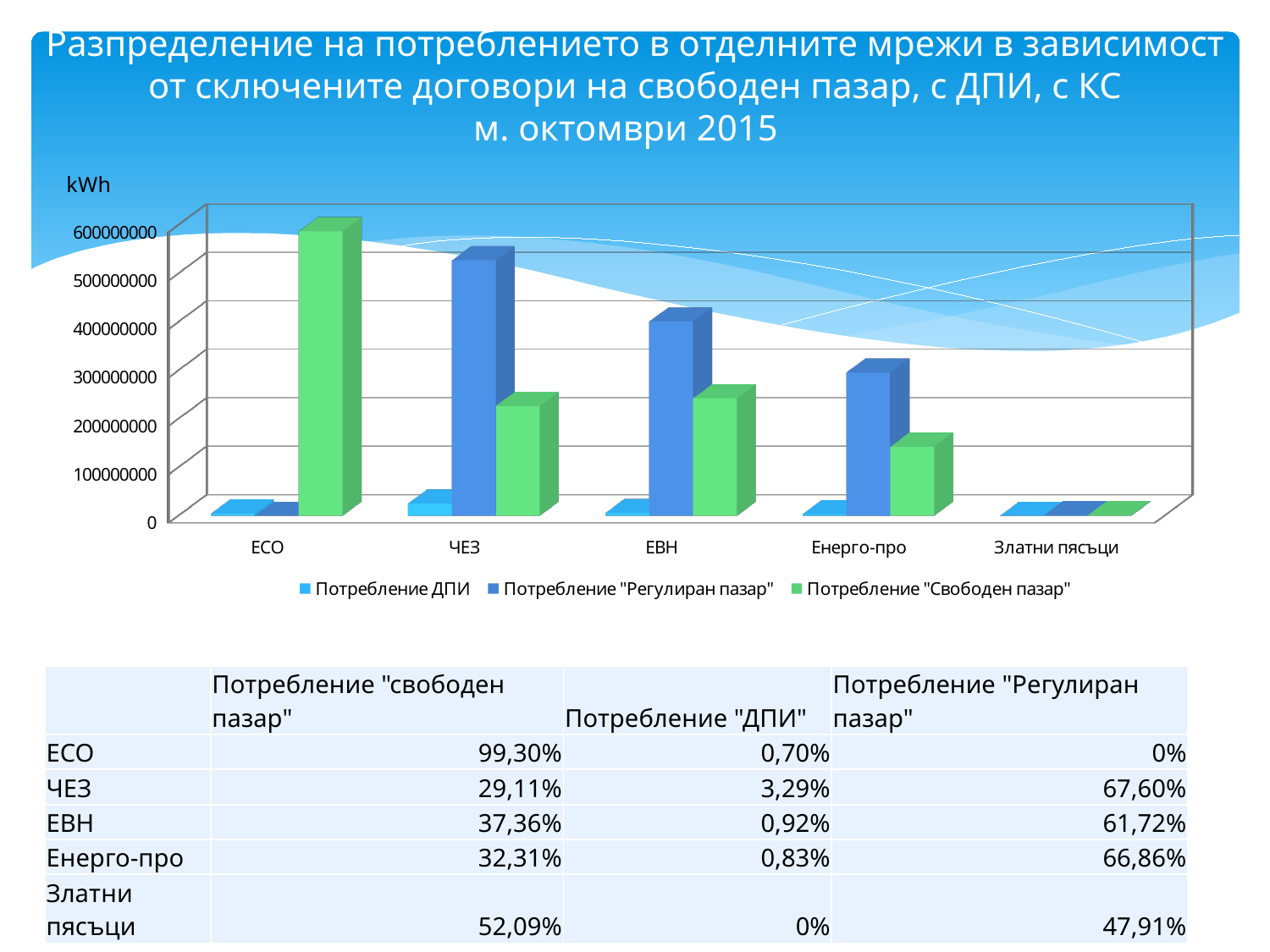
Which category has the highest value for the series Потребление "Регулиран пазар"? ЧЕЗ Which is larger: Потребление "Регулиран пазар" for ЧЕЗ or for ЕВН? ЧЕЗ How many series does the chart legend list? 3 Is the value of Потребление "Свободен пазар" for ЕСО greater or less than 500000000? greater Is the value of Потребление "Свободен пазар" for Енерго-про greater or less than 200000000? less What kind of chart is shown on the slide? bar chart Which category has the highest value for the series Потребление "Свободен пазар"? ЕСО What unit is shown above the vertical axis of the chart? kWh Is the value of Потребление "Регулиран пазар" for Енерго-про greater or less than 400000000? less Which is larger: Потребление "Свободен пазар" for ЕВН or for Енерго-про? ЕВН How many categories are shown on the x axis of the chart? 5